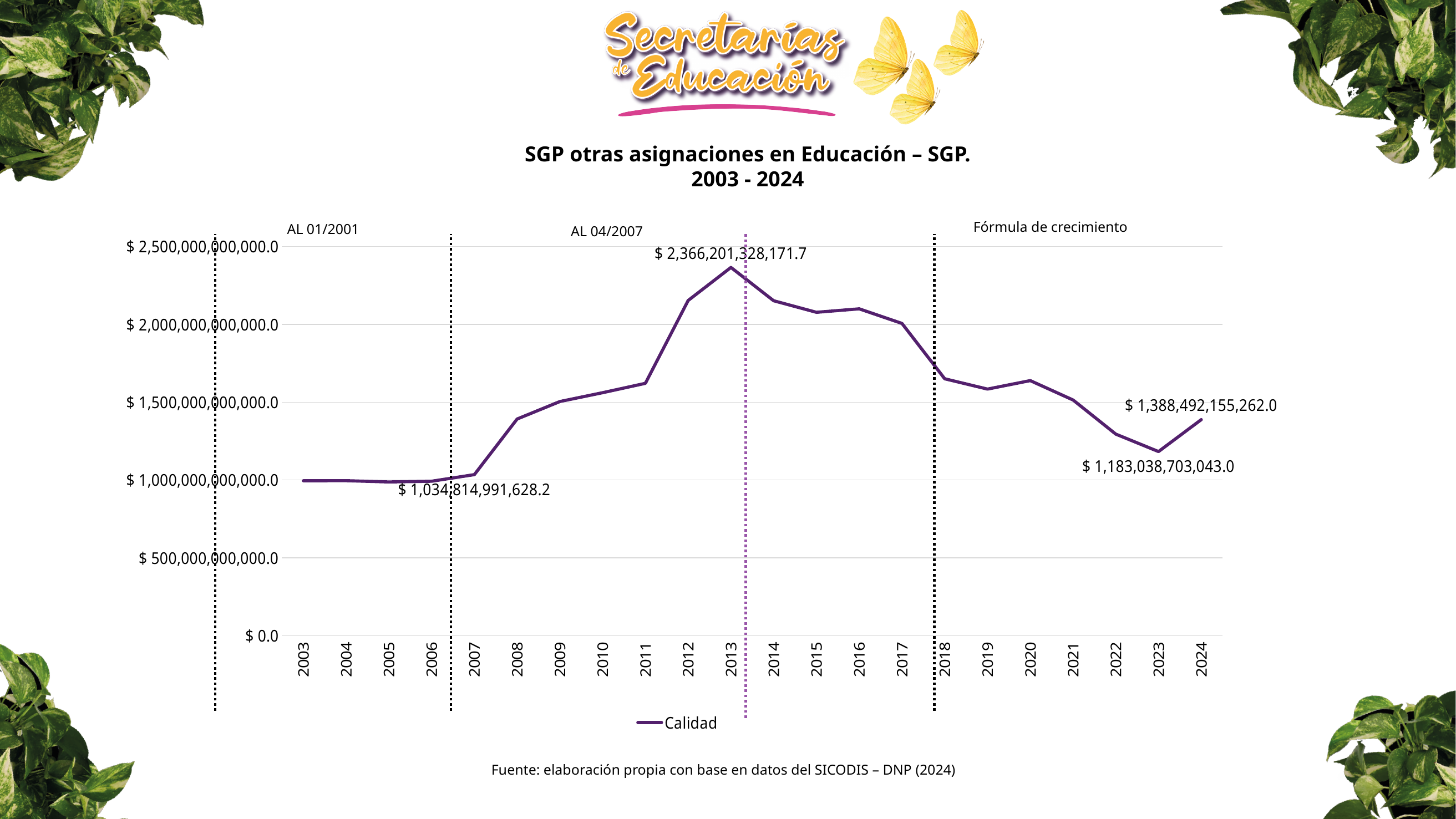
How many series does the legend list? 1 What is the value for Calidad in 2024? $ 1,388,492,155,262.0 What kind of chart is shown on the slide? Line chart What is the difference between the Calidad values for 2024 and 2023? $ 205,453,452,219.0 What is the value for Calidad in 2023? $ 1,183,038,703,043.0 What is the name of the series shown in the legend? Calidad How many years are plotted along the x axis? 22 Does the Calidad value rise or fall from 2013 to 2023? Fall What is the title of the chart? SGP otras asignaciones en Educación – SGP. 2003 - 2024 Is the value for 2011 greater or less than $ 1,500,000,000,000.0? greater In which year is the Calidad value highest? 2013 What is the value for Calidad in 2013? $ 2,366,201,328,171.7